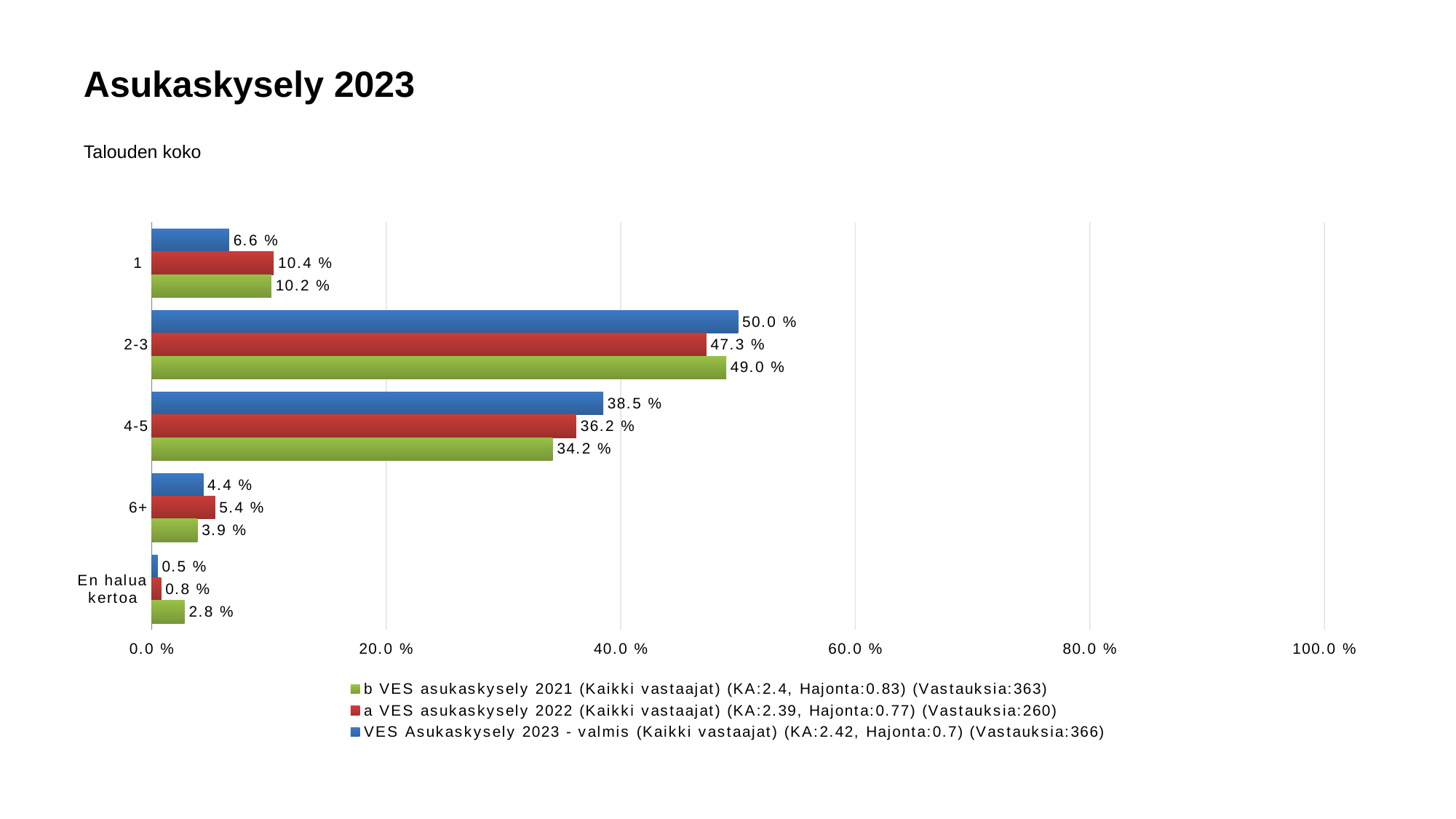
What is the subtitle of the chart below the slide title? Talouden koko What is the value for the '6+' category in the a VES asukaskysely 2022 series? 5.4 % What is the difference between the 2023 and 2022 values for the '4-5' category? 2.3 % What kind of chart is shown on the slide? bar chart What is the value for the '2-3' category in the VES Asukaskysely 2023 series? 50.0 % What is the value for the '4-5' category in the b VES asukaskysely 2021 series? 34.2 % Is the value for '2-3' in the b VES asukaskysely 2021 series greater or less than 40.0 %? greater How many series does the legend list? 3 Which category has the highest value in the VES Asukaskysely 2023 series? 2-3 Which category has the lowest value in the a VES asukaskysely 2022 series? En halua kertoa For the '1' category, which series has the larger value: a VES asukaskysely 2022 or VES Asukaskysely 2023? a VES asukaskysely 2022 How many categories are shown on the chart? 5